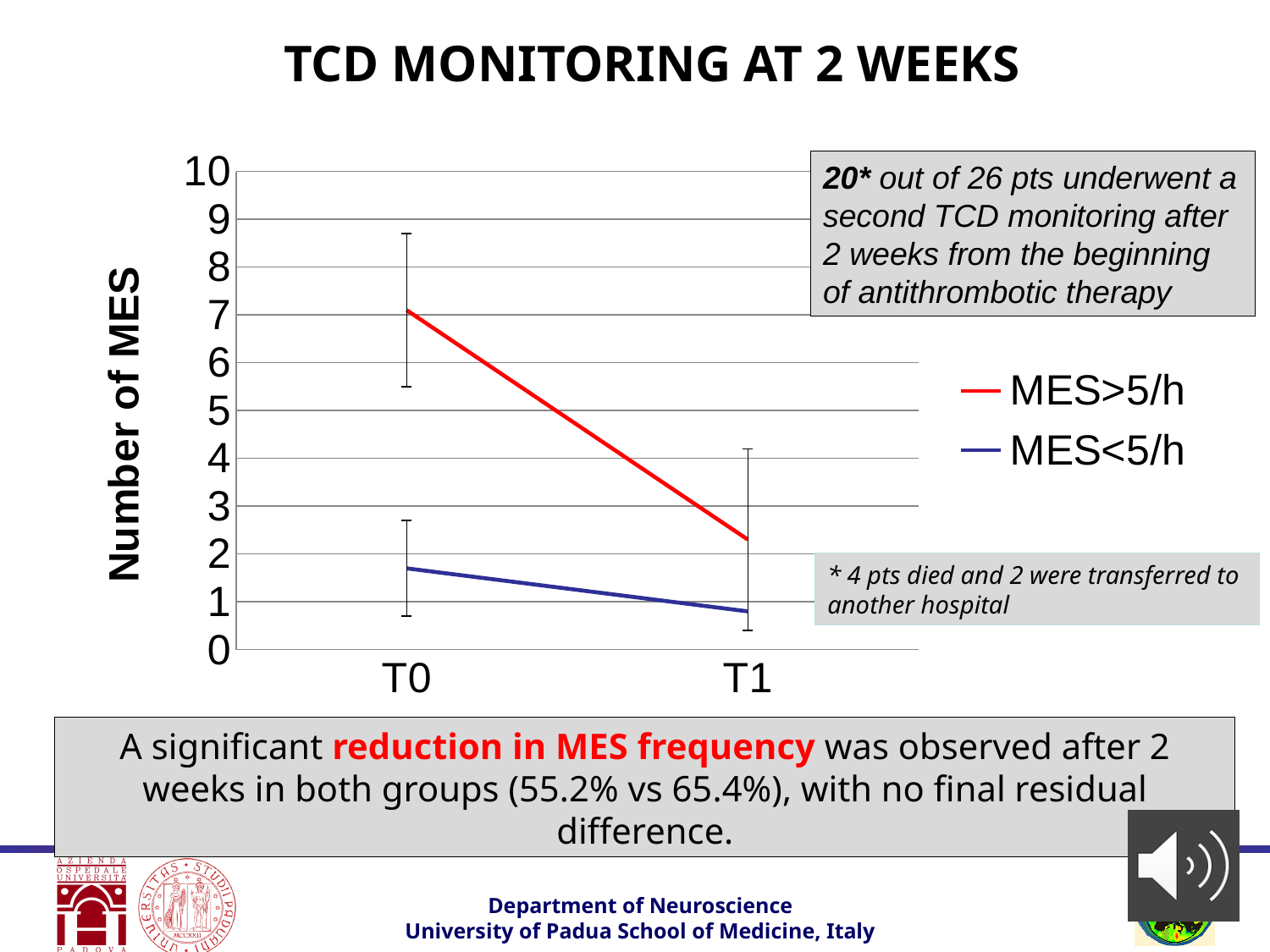
How many time points are shown on the x axis? 2 At T1, which series has the higher number of MES, MES>5/h or MES<5/h? MES>5/h What kind of chart is shown on the slide? line chart How many series does the legend list? 2 Does the MES>5/h line rise or fall from T0 to T1? fall What is the label of the y axis? Number of MES Is the value for MES>5/h at T1 greater or less than 3? less Is the value for MES>5/h at T0 greater or less than 6? greater Is the value for MES<5/h at T0 greater or less than 1? greater Does the MES<5/h line rise or fall from T0 to T1? fall Which colour is used for the MES<5/h series? blue At T0, which series has the higher number of MES, MES>5/h or MES<5/h? MES>5/h